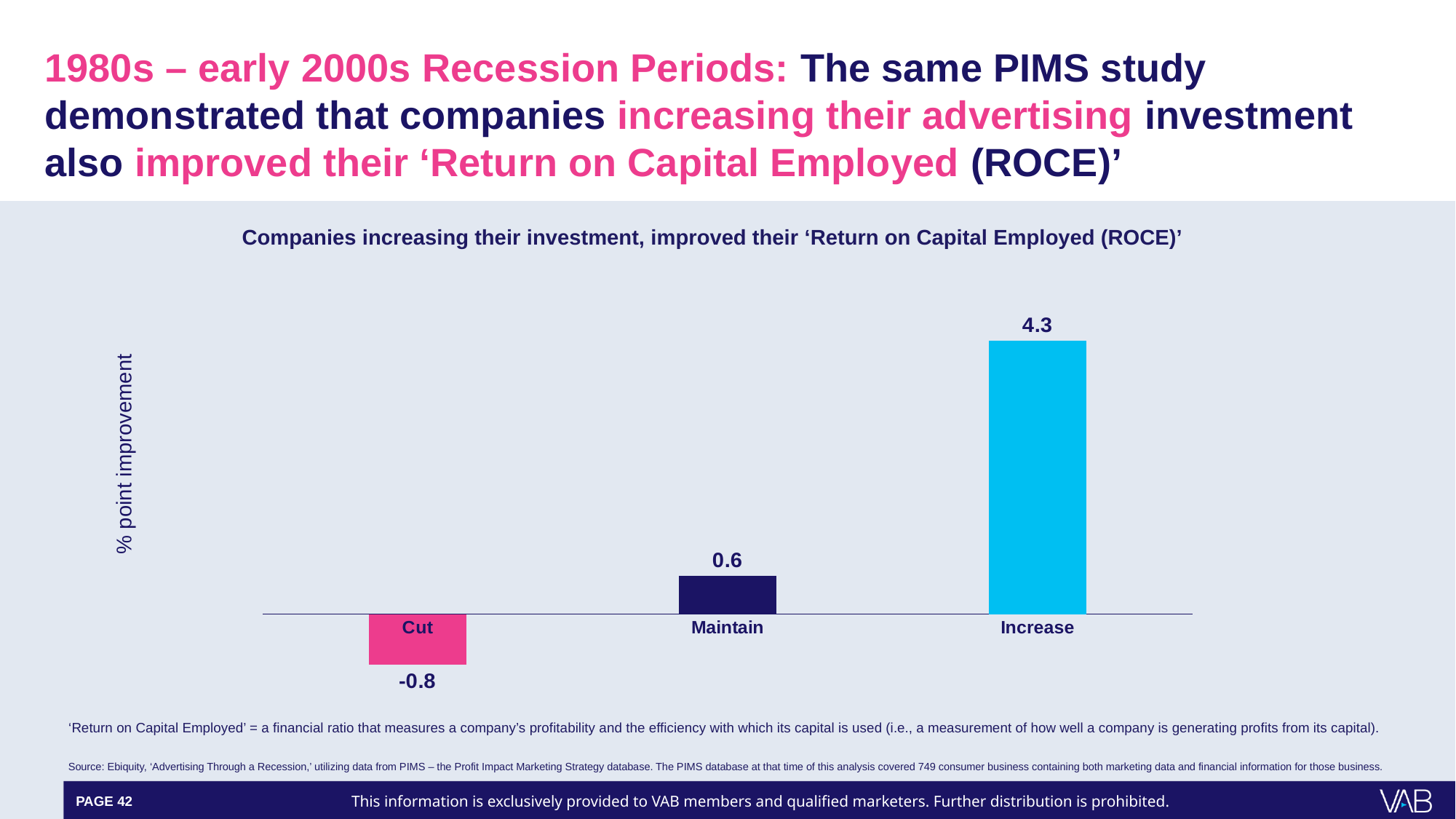
What kind of chart is shown on the slide? Bar chart What is the value for Increase? 4.3 What is the label on the vertical axis of the chart? % point improvement Do the values rise or fall moving from Cut to Increase along the x axis? Rise What is the value for Cut? -0.8 Which category has the highest value? Increase What is the difference between the values for Increase and Maintain? 3.7 What is the value for Maintain? 0.6 Which category has the lowest value? Cut Which is larger, the value for Maintain or the value for Cut? Maintain How many categories are shown in the chart? 3 What is the difference between the values for Maintain and Cut? 1.4